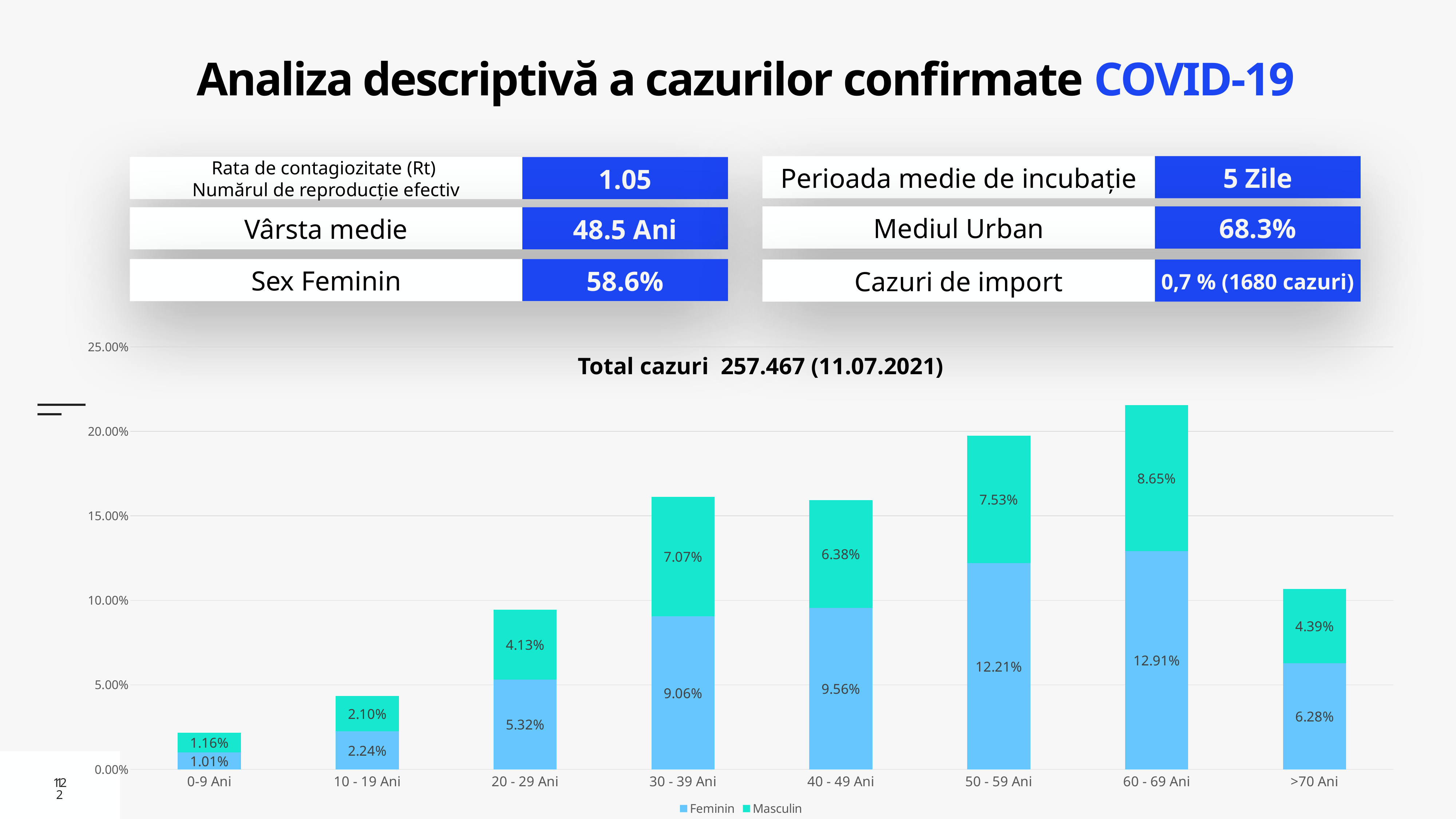
Which age group has the lowest Masculin value? 0-9 Ani What is the Feminin value for the 60 - 69 Ani age group? 12.91% How many series does the legend list? 2 Which is larger for the 40 - 49 Ani age group, the Feminin value or the Masculin value? Feminin What is the Feminin value for the >70 Ani age group? 6.28% What is the difference between the Feminin and Masculin values for the 50 - 59 Ani age group? 4.68% How many age groups are shown on the x axis? 8 Which series is shown in the darker teal colour in the legend? Masculin What is the total of the stacked bar for the 60 - 69 Ani age group? 21.56% What kind of chart is shown on the slide? Stacked bar chart Which age group has the highest Feminin value? 60 - 69 Ani What is the Masculin value for the 30 - 39 Ani age group? 7.07%